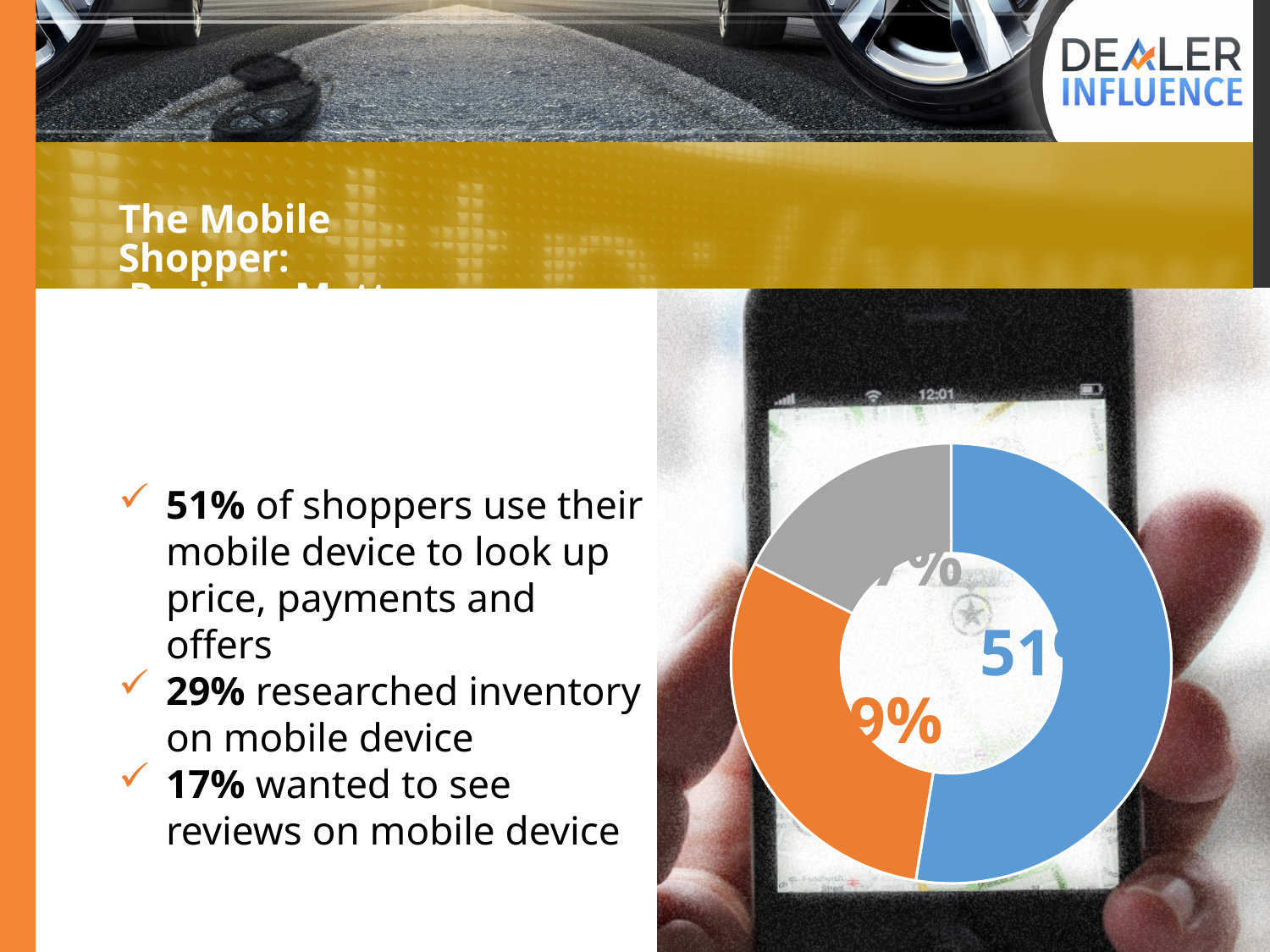
What percentage does the gray slice of the doughnut chart represent? 17% Which is larger in the doughnut chart, the orange slice or the gray slice? The orange slice What percentage does the blue slice of the doughnut chart represent? 51% What percentage does the orange slice of the doughnut chart represent? 29% What is the difference in percentage points between the blue slice (51%) and the orange slice (29%)? 22 percentage points Which slice of the doughnut chart is the largest? The blue slice (51%) Which is larger in the doughnut chart, the blue slice or the orange slice? The blue slice Is the blue slice of the doughnut chart greater or less than half of the whole? greater What kind of chart is shown on the slide? Doughnut (pie) chart What colour is the slice representing shoppers who researched inventory on a mobile device (29%)? Orange Which slice of the doughnut chart is the smallest? The gray slice (17%) How many slices does the doughnut chart have? 3